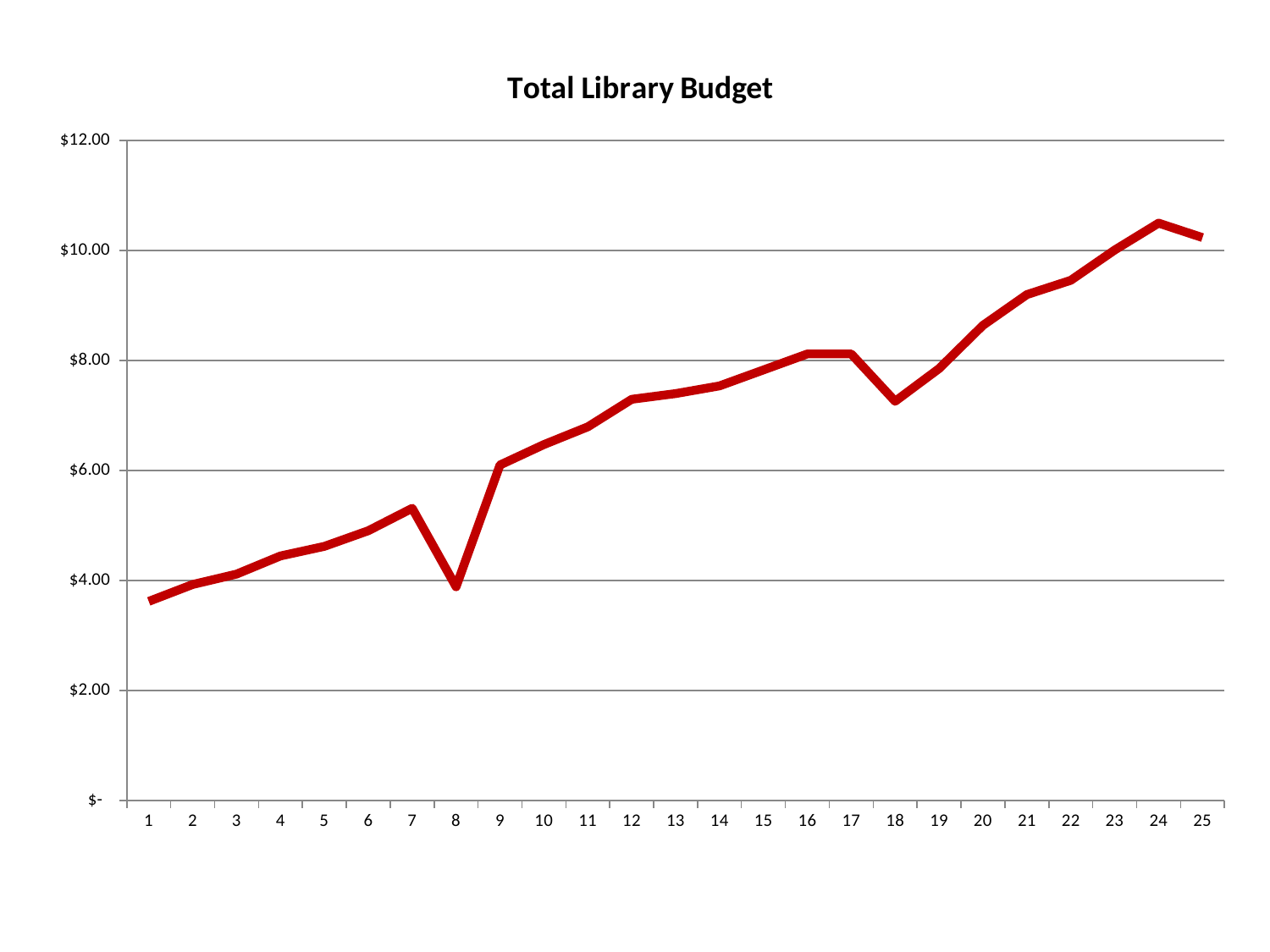
What kind of chart is shown on the slide? line chart Which x-axis point has the lowest value? 1 Which has the larger value, point 7 or point 8? 7 What is the title of the chart? Total Library Budget Which x-axis point has the highest value? 24 Is the value at point 24 greater or less than $10.00? greater Which has the larger value, point 12 or point 20? 20 Overall, do the values rise or fall from point 1 to point 25? rise Is the value at point 18 greater or less than $8.00? less How many points are plotted along the x axis? 25